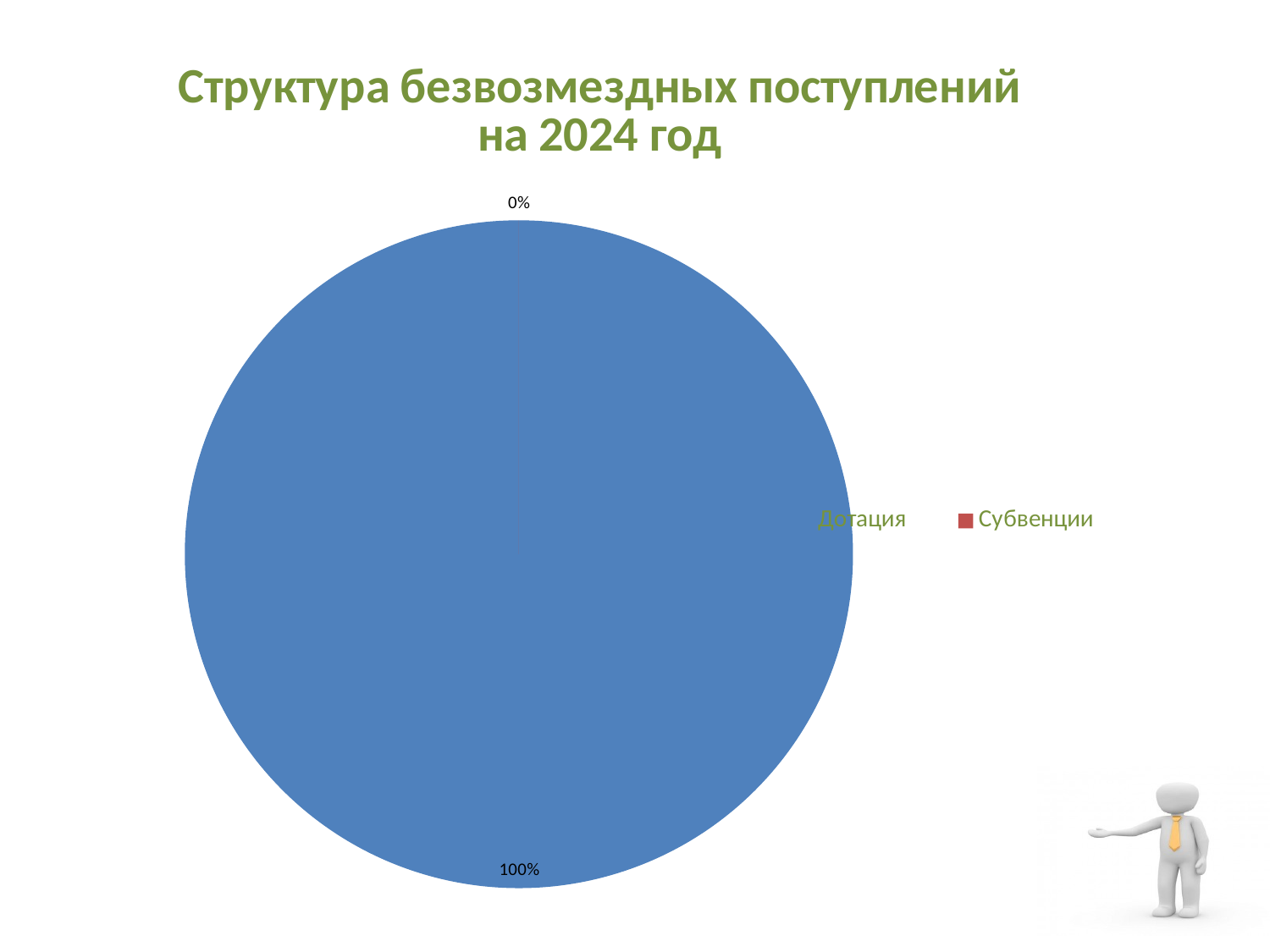
Which is larger, the share for Дотация or the share for Субвенции? Дотация What is the difference between the share for Дотация and the share for Субвенции? 100% What is the title of the chart? Структура безвозмездных поступлений на 2024 год What share of the pie does Субвенции take? 0% What colour is the slice for Дотация? blue How many percentage labels are printed on the pie chart? 2 What kind of chart is shown on the slide? pie chart What share of the pie does Дотация take? 100% Which category has the smallest share of the pie? Субвенции Which category has the largest share of the pie? Дотация How many categories does the legend of the pie chart list? 2